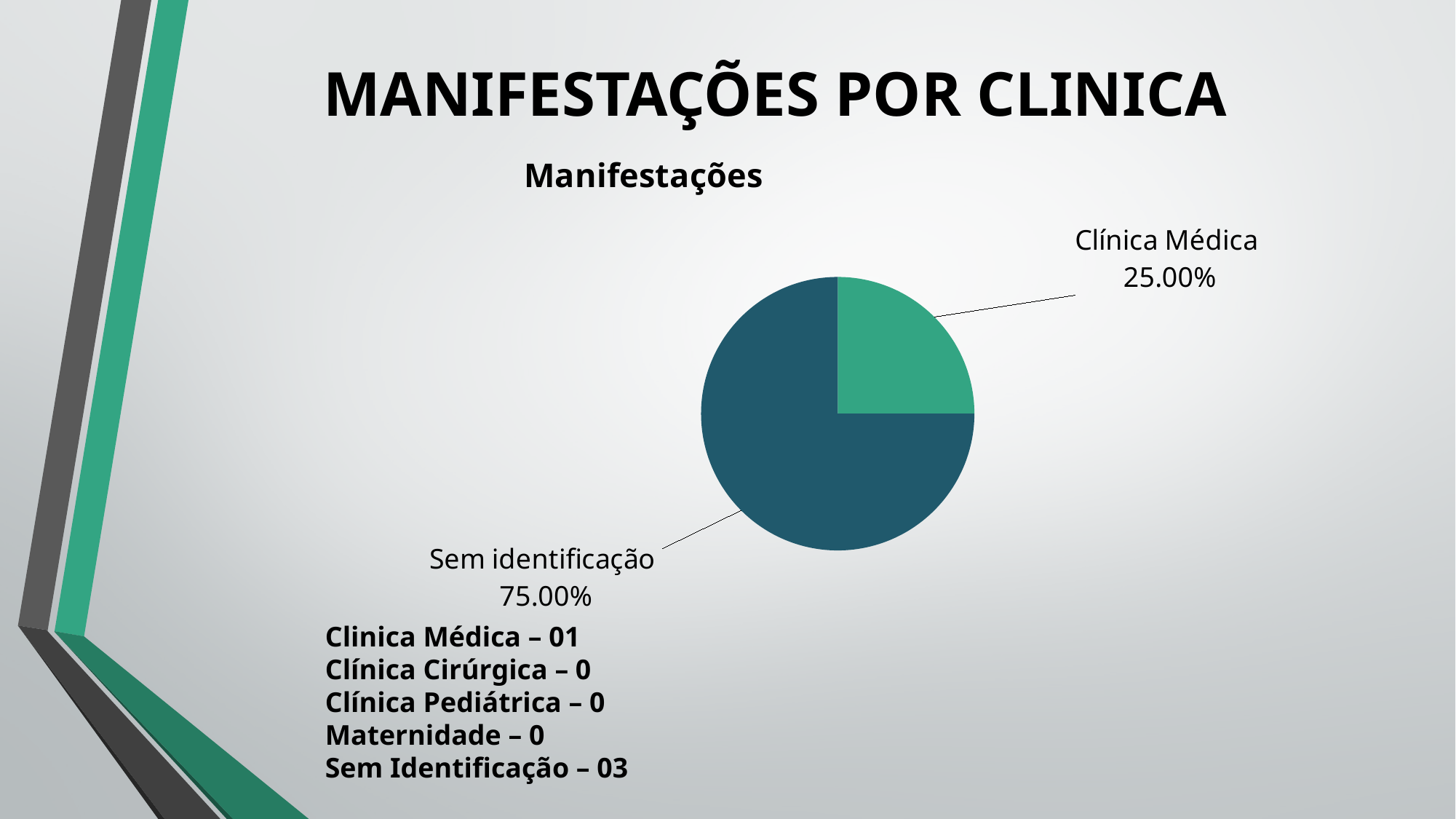
Is the share for Clínica Médica greater or less than 50%? less What is the difference in percentage points between the Sem identificação slice and the Clínica Médica slice? 50.00% What share of the pie does Sem identificação represent? 75.00% What kind of chart is shown on the slide? pie chart Which is larger, the share for Sem identificação or the share for Clínica Médica? Sem identificação What share of the pie does Clínica Médica represent? 25.00% What colour is the Sem identificação slice? dark teal Which slice of the pie is the largest? Sem identificação What is the chart's title? Manifestações How many slices does the pie chart have? 2 Which slice of the pie is the smallest? Clínica Médica